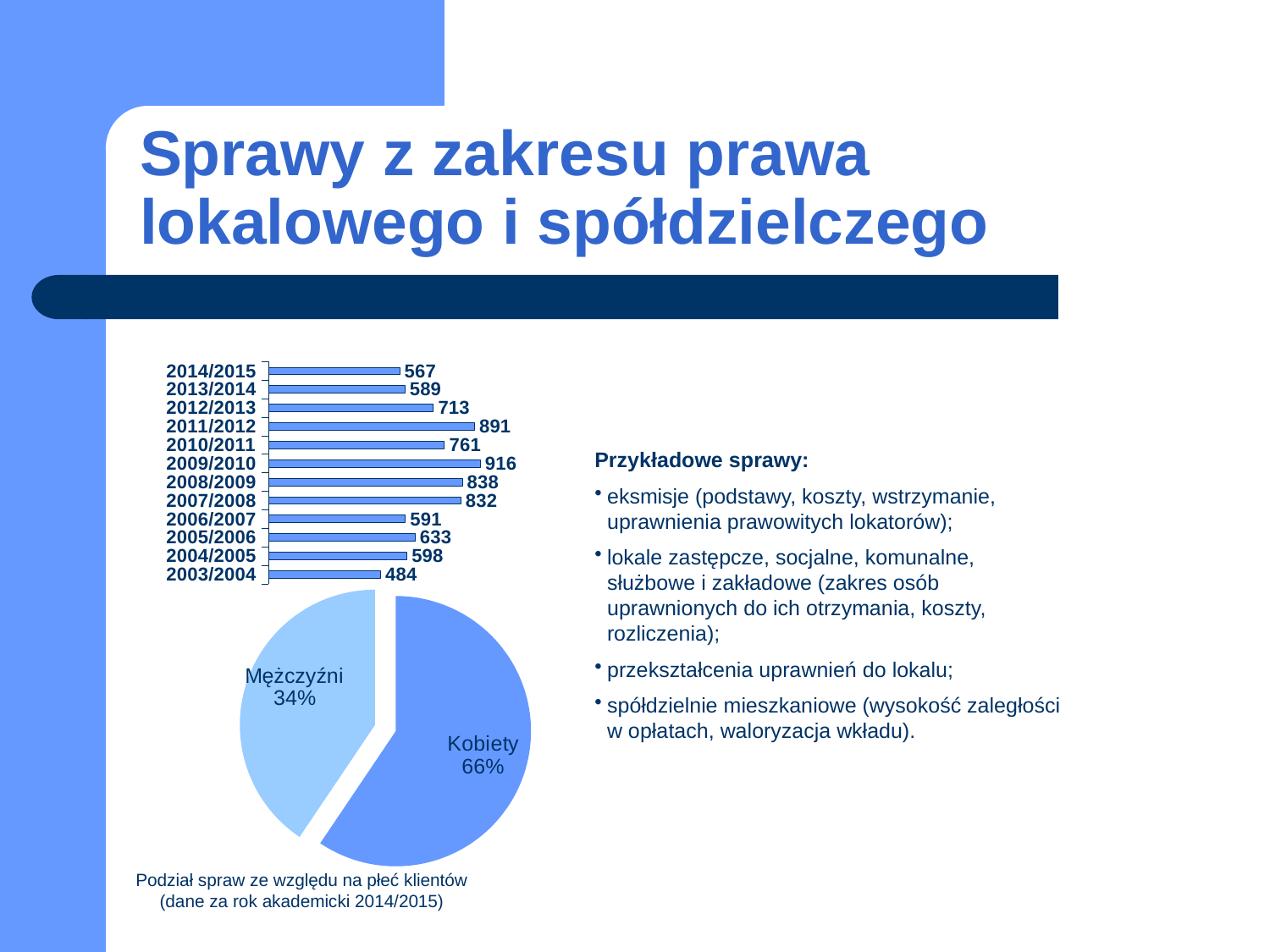
In the bar chart, which academic year has the highest value? 2009/2010 In the bar chart, which is larger, the value for 2008/2009 or the value for 2007/2008? 2008/2009 How many slices does the pie chart have? 2 In the bar chart, what is the difference between the values for 2011/2012 and 2012/2013? 178 How many academic years are shown in the bar chart? 12 What kind of chart is the upper chart on the slide? bar chart In the pie chart, what share is labelled Kobiety? 66% In the bar chart, what is the value for 2003/2004? 484 In the bar chart, which academic year has the lowest value? 2003/2004 In the bar chart, what is the value for 2014/2015? 567 In the pie chart, what share is labelled Mężczyźni? 34% What is the caption below the pie chart? Podział spraw ze względu na płeć klientów (dane za rok akademicki 2014/2015)